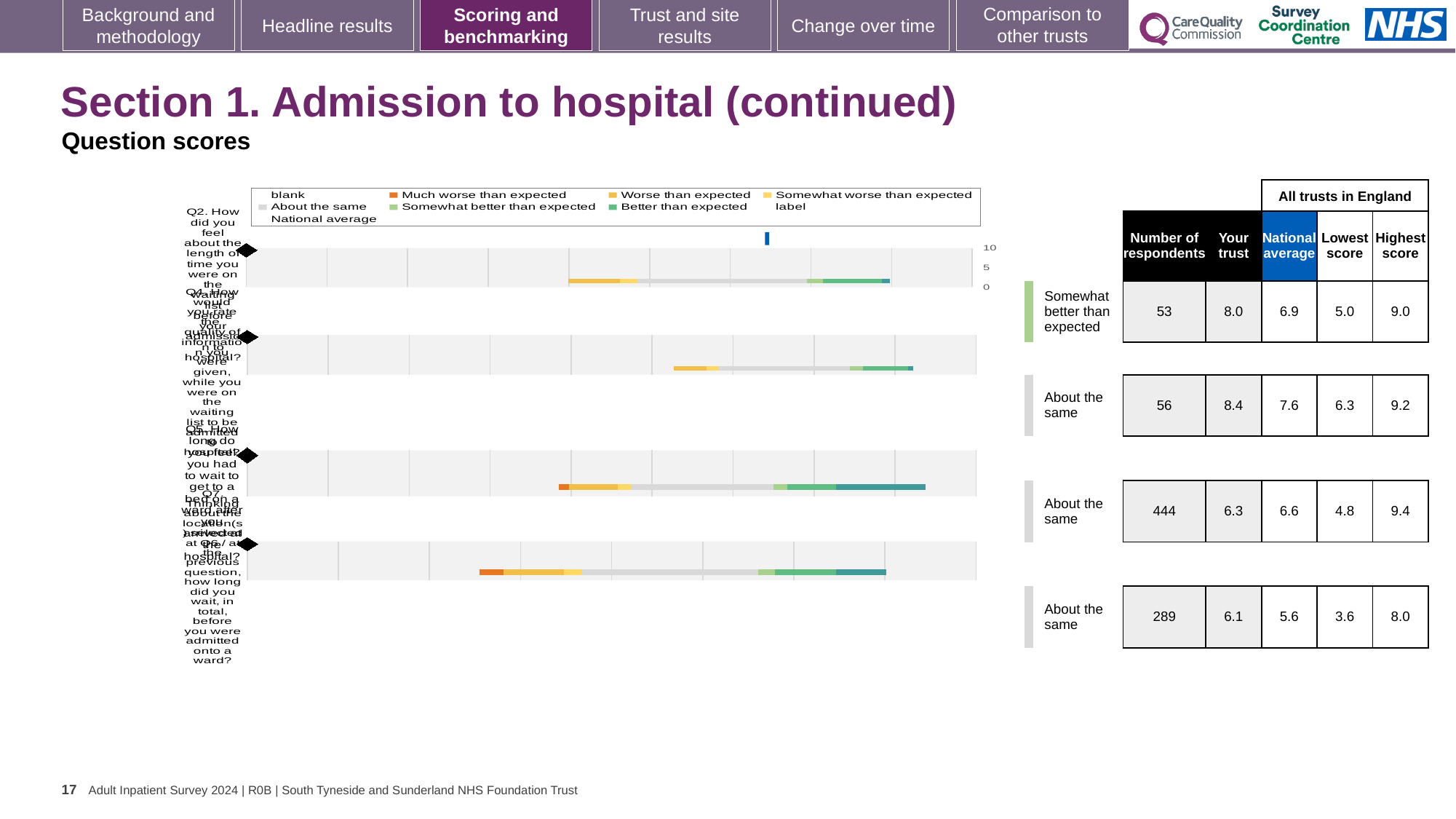
Which legend entry in the chart is shown in dark orange? Much worse than expected In the table beside the chart, what is the 'Your trust' score for the row with 53 respondents? 8.0 In the table beside the chart, what is the difference between 'Your trust' and the National average for the row with 56 respondents? 0.8 In the table beside the chart, which row has the highest number of respondents? 444 In the table beside the chart, what is the Lowest score for the row with 289 respondents? 3.6 What is the highest tick value shown on the chart's numeric axis? 10 How many horizontal bars (questions) are plotted in the chart? 4 In the table beside the chart, is 'Your trust' or the National average larger for the row with 289 respondents? Your trust What kind of chart is shown on the slide? bar chart In the table beside the chart, what is the National average for the row with 444 respondents? 6.6 How many of the rows beside the chart are labelled 'About the same'? 3 In the table beside the chart, what is the Highest score for the row with 444 respondents? 9.4